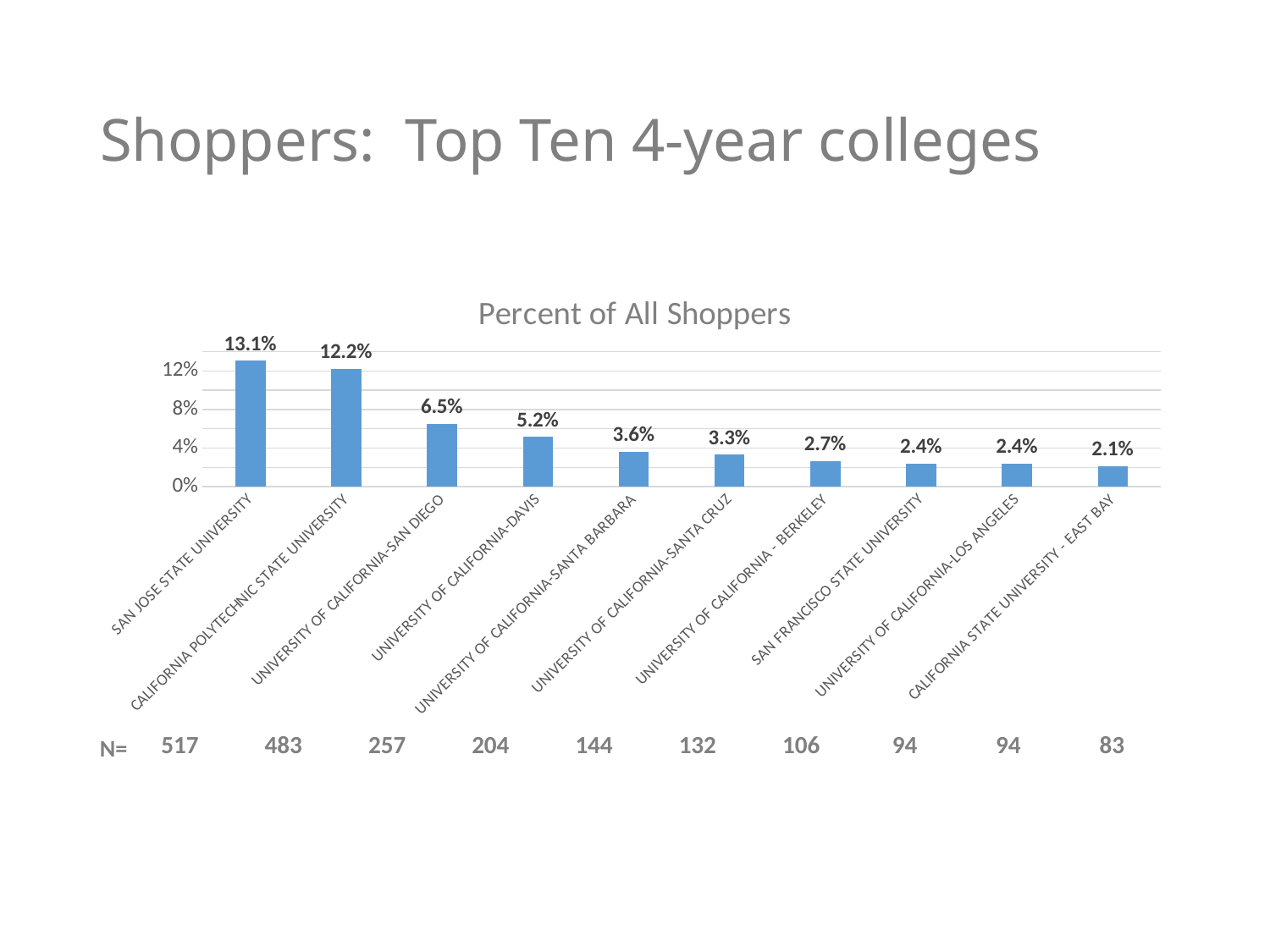
What is the value for University of California-Santa Cruz? 3.3% Which college has the lowest percent of all shoppers? California State University - East Bay Which college has the highest percent of all shoppers? San Jose State University What is the value for University of California-San Diego? 6.5% Which is larger, the value for University of California-Davis or University of California-Santa Barbara? University of California-Davis How many colleges are shown in the chart? 10 What is the difference between the values for San Jose State University and California Polytechnic State University? 0.9% What kind of chart is shown on the slide? bar chart What is the value for San Jose State University? 13.1% Is the value for University of California-San Diego greater or less than 8%? less What is the title of the chart? Percent of All Shoppers Do the values rise or fall from left to right along the x axis? fall